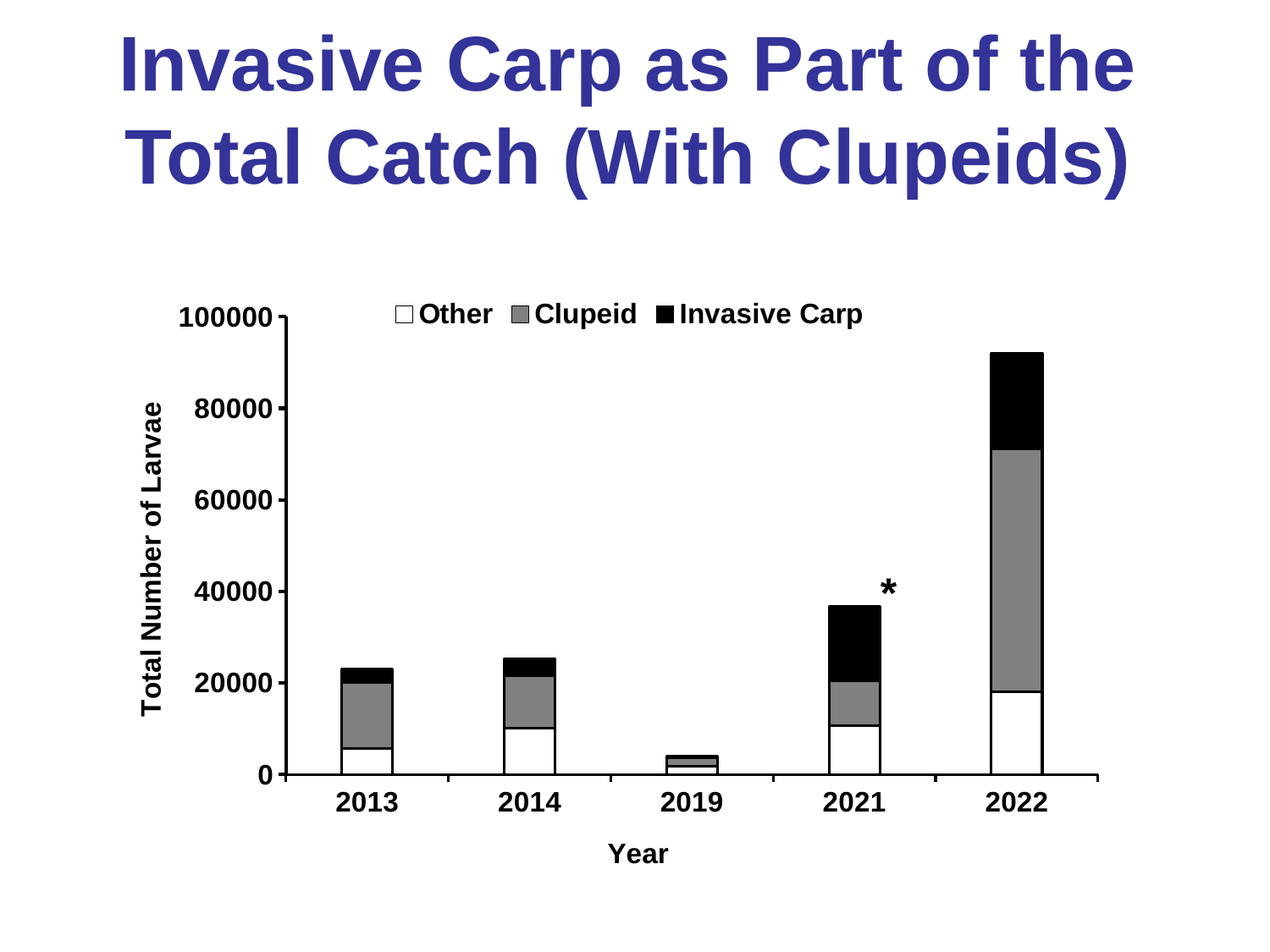
Which year has a larger total number of larvae, 2014 or 2021? 2021 Which year has the highest total number of larvae? 2022 Is the total number of larvae for 2013 greater or less than 20000? greater Which year has the lowest total number of larvae? 2019 How many series does the chart's legend list? 3 Is the total number of larvae for 2022 greater or less than 80000? greater Is the total number of larvae for 2019 greater or less than 20000? less How many years are shown on the x axis of the chart? 5 Which year's bar is marked with an asterisk? 2021 What are the three series listed in the chart's legend? Other, Clupeid, Invasive Carp What kind of chart is shown on the slide? Stacked bar chart